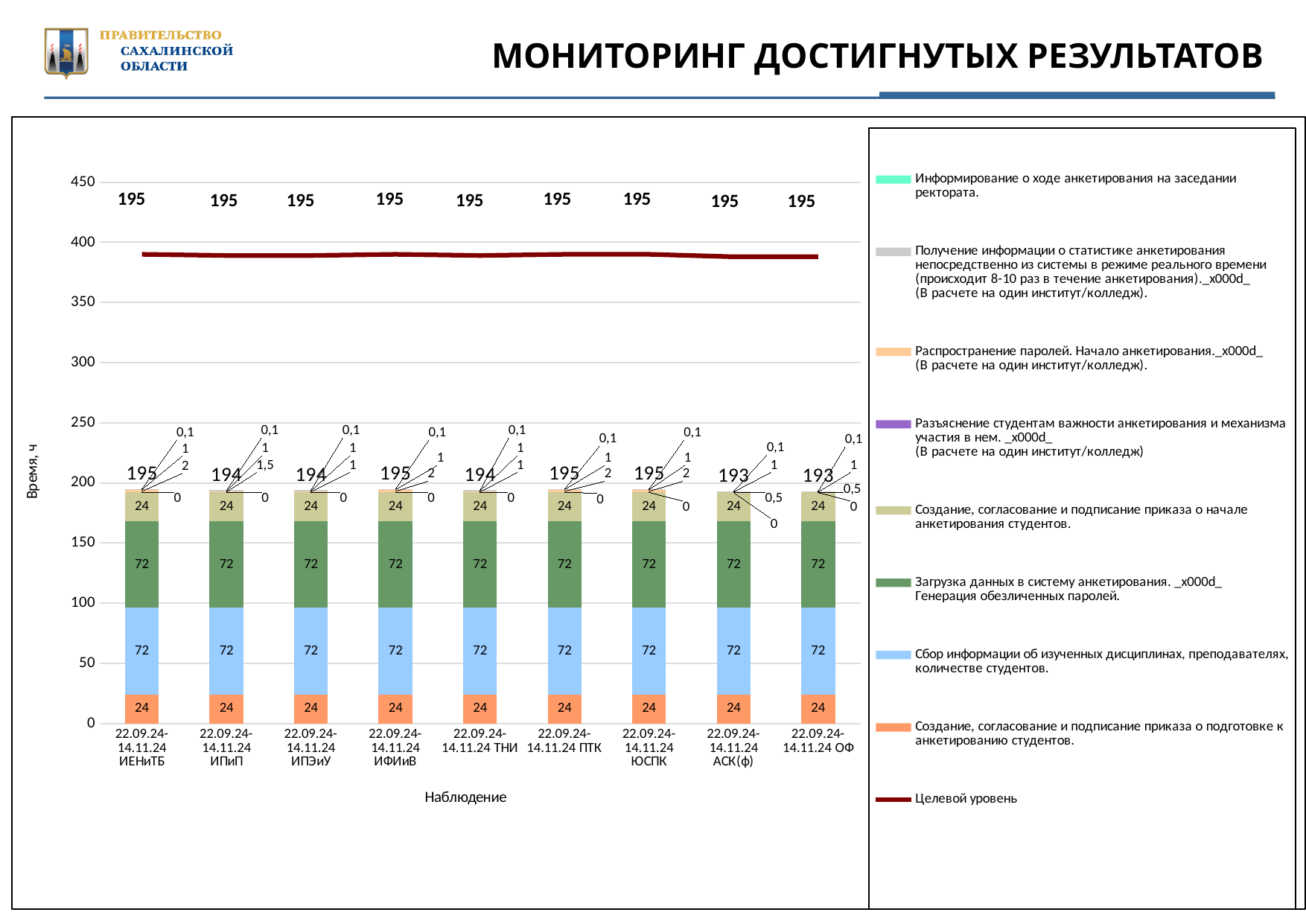
Which has the larger total: ИПиП or ПТК? ПТК How many categories (observations) are shown along the x axis? 9 What value is labelled on the Целевой уровень line for each observation? 195 What is the title of the y axis? Время, ч What is the total value labelled above the stacked bar for 22.09.24-14.11.24 АСК(ф)? 193 What is the value of the green segment (Загрузка данных в систему анкетирования) for 22.09.24-14.11.24 ТНИ? 72 Is the Целевой уровень line plotted greater or less than 350 on the y axis? greater What is the value of the orange segment (Создание, согласование и подписание приказа о подготовке к анкетированию студентов) for 22.09.24-14.11.24 ОФ? 24 What is the difference between the total for ИЕНиТБ and the total for ОФ? 2 How many entries does the legend list? 9 What kind of chart is shown on the slide? Stacked bar chart with a line What is the total value labelled above the stacked bar for 22.09.24-14.11.24 ИЕНиТБ? 195